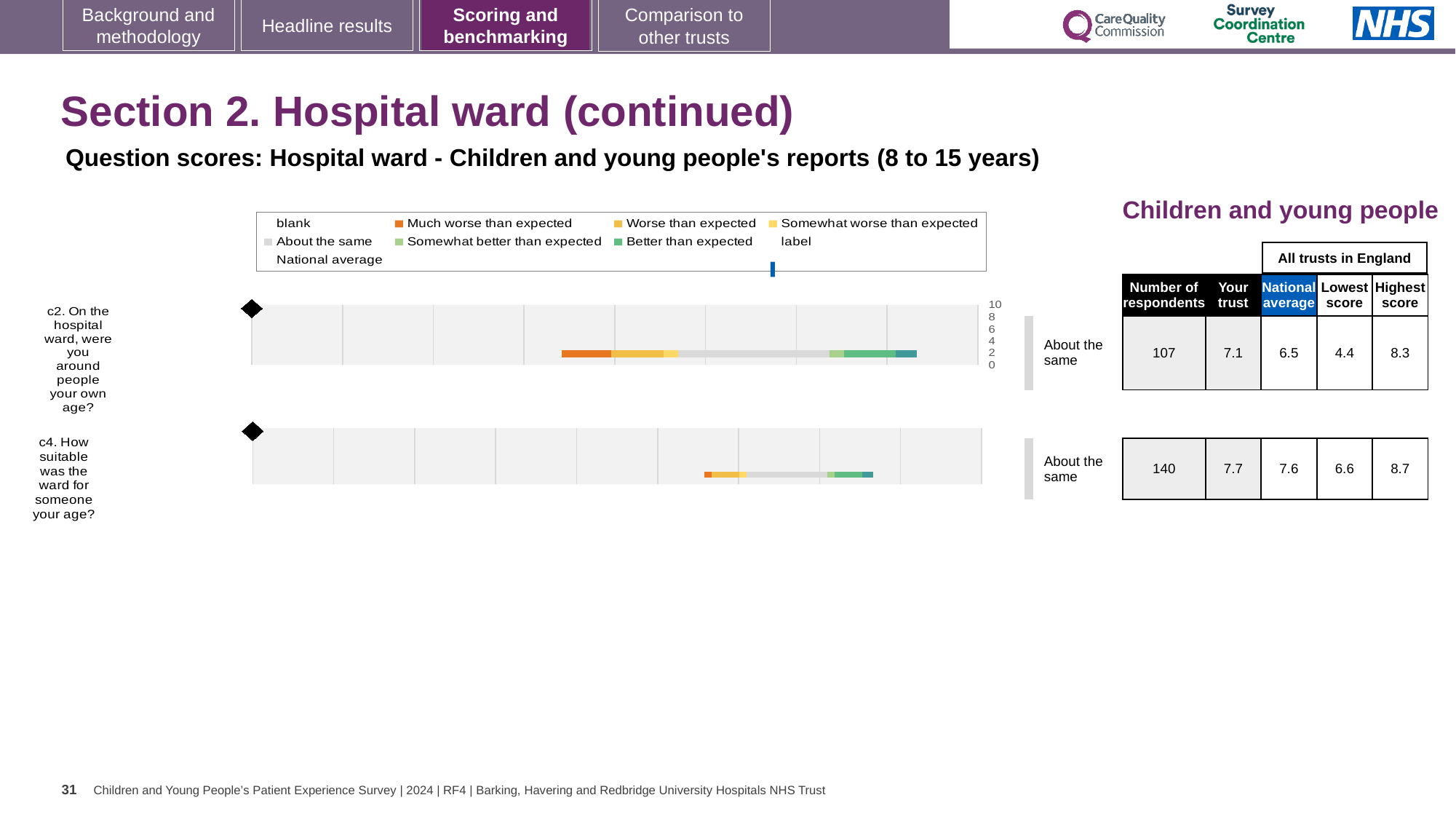
What colour represents 'Much worse than expected' in the legend? orange Which question has the higher 'Your trust' score, c2 or c4? c4 How many questions are plotted in the chart? 2 What is the national average score for c4 (How suitable was the ward for someone your age?)? 7.6 What is the lowest score across all trusts in England for c2? 4.4 What kind of chart is used to show the question scores for c2 and c4? bar chart By how much does the trust's score for c2 exceed the national average? 0.6 What benchmark category is shown for c4? About the same How many respondents answered question c2? 107 What is the difference between the highest and lowest scores for c4? 2.1 What is the 'Your trust' score for c2 (On the hospital ward, were you around people your own age?)? 7.1 Which question has the higher highest score across all trusts in England? c4